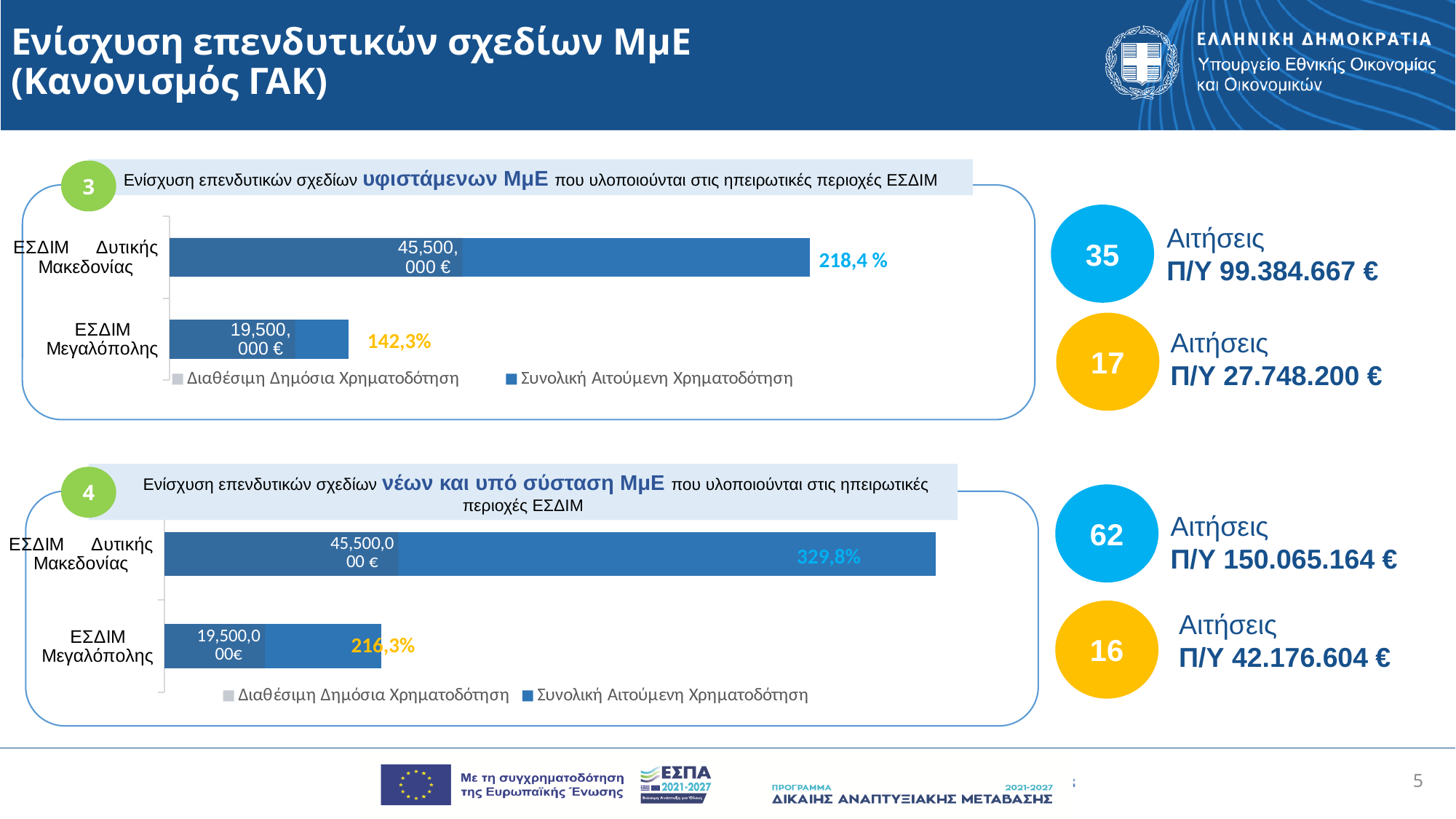
On the top chart (existing SMEs, section 3), what is the available public funding (Διαθέσιμη Δημόσια Χρηματοδότηση) for ΕΣΔΙΜ Δυτικής Μακεδονίας? 45,500,000 € On the top chart (existing SMEs, section 3), what percentage is shown next to the bar for ΕΣΔΙΜ Δυτικής Μακεδονίας? 218,4 % On the bottom chart (section 4), which category has the smaller total requested funding bar? ΕΣΔΙΜ Μεγαλόπολης On the bottom chart (new and under-establishment SMEs, section 4), what percentage is shown for ΕΣΔΙΜ Δυτικής Μακεδονίας? 329,8% On the bottom chart (new and under-establishment SMEs, section 4), what percentage is shown for ΕΣΔΙΜ Μεγαλόπολης? 216,3% On the bottom chart (section 4), what is the available public funding for ΕΣΔΙΜ Μεγαλόπολης? 19,500,000€ What type of chart is used in the top chart (section 3)? Bar chart How many categories are plotted on the top chart (section 3)? 2 How many series does the legend of the bottom chart (section 4) list? 2 On the top chart (existing SMEs, section 3), what is the available public funding for ΕΣΔΙΜ Μεγαλόπολης? 19,500,000 € On the top chart (existing SMEs, section 3), what percentage is shown next to the bar for ΕΣΔΙΜ Μεγαλόπολης? 142,3% On the top chart (section 3), which category has the larger total requested funding bar? ΕΣΔΙΜ Δυτικής Μακεδονίας